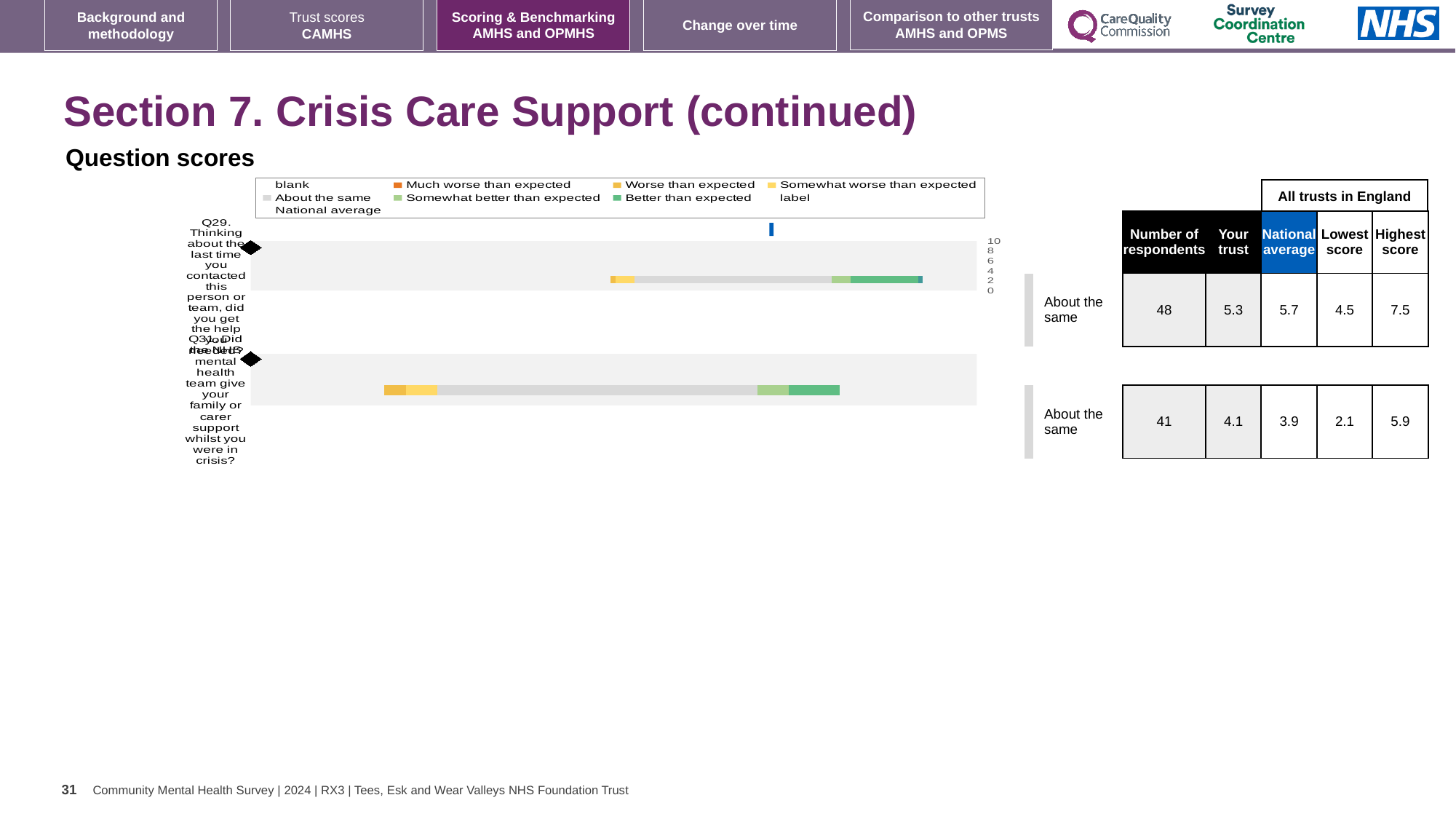
How many entries does the legend of the question scores chart list? 9 In the legend of the question scores chart, what colour represents 'Much worse than expected'? orange How many respondents answered Q31? 41 Which question has more respondents, Q29 or Q31? Q29 For Q29, which is larger: the 'Your trust' score or the national average? national average What is the national average for Q31 in the table beside the chart? 3.9 How many questions are plotted in the question scores chart? 2 What is the 'Your trust' score for Q29 in the table beside the chart? 5.3 In the legend of the question scores chart, what colour represents 'Better than expected'? green What is the difference between the 'Your trust' score and the national average for Q31? 0.2 What kind of chart is used to show the question scores? bar chart What is the difference between the national average and the 'Your trust' score for Q29? 0.4